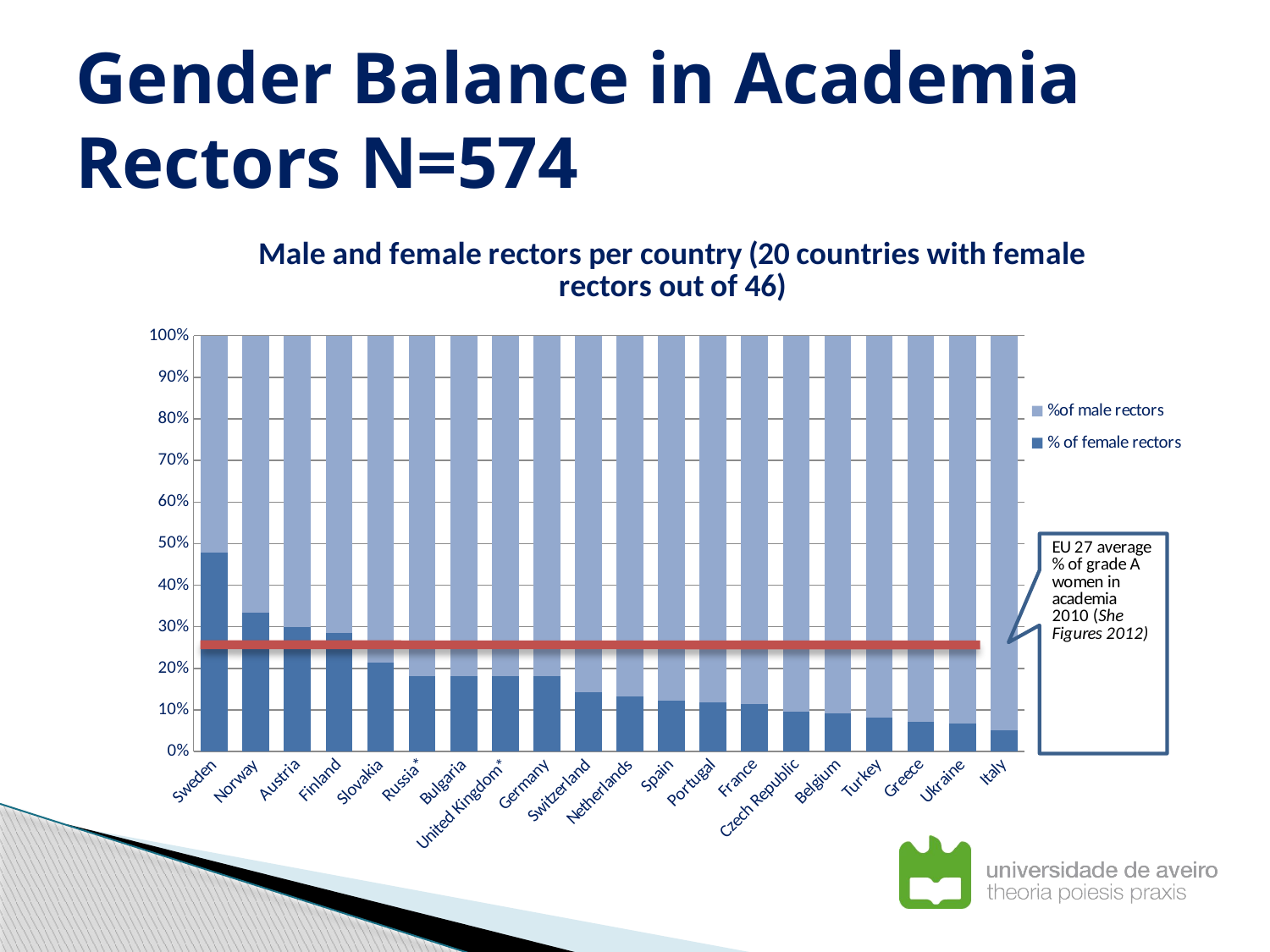
Does the % of female rectors rise or fall moving from left to right along the x axis? fall Is the % of female rectors for Norway greater or less than 30%? greater How many series does the chart's legend list? 2 What does the red horizontal line on the chart represent? EU 27 average % of grade A women in academia 2010 (She Figures 2012) How many countries are shown on the x axis of the chart? 20 Which country has a larger % of female rectors, Norway or Austria? Norway Which country has the highest % of female rectors? Sweden Which country has the lowest % of female rectors? Italy Is the % of female rectors for Italy greater or less than 10%? less What kind of chart is shown on the slide? bar chart Is the % of female rectors for Sweden greater or less than 40%? greater